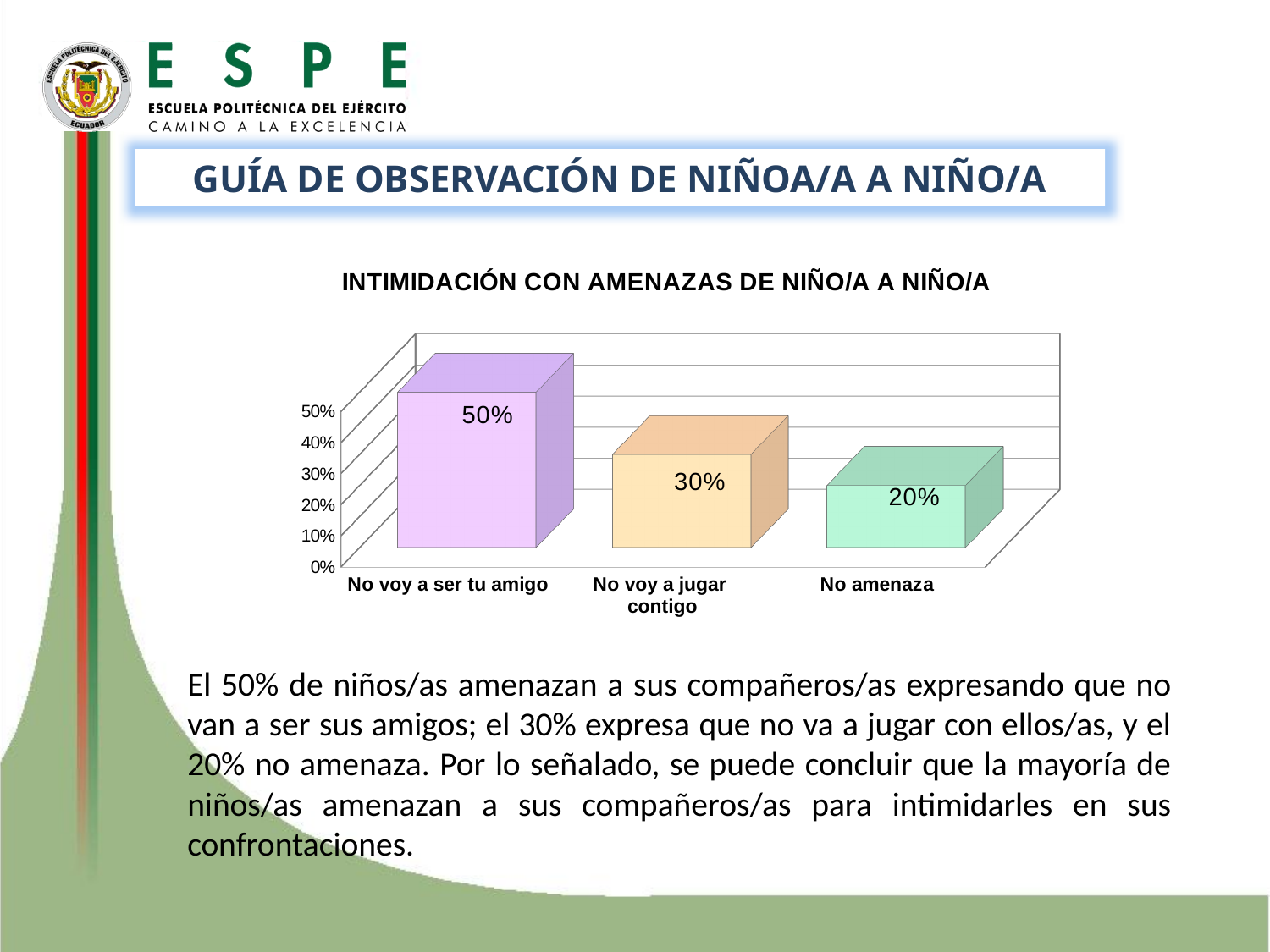
Which category has the lowest value? No amenaza What is the value for "No amenaza"? 20% Which category has the highest value? No voy a ser tu amigo How many categories are shown on the chart? 3 What is the difference between the values for "No voy a ser tu amigo" and "No amenaza"? 30% What is the title of the chart? INTIMIDACIÓN CON AMENAZAS DE NIÑO/A A NIÑO/A What is the value for "No voy a ser tu amigo"? 50% What is the difference between the values for "No voy a jugar contigo" and "No amenaza"? 10% Do the values rise or fall from left to right along the x axis? Fall What kind of chart is shown on the slide? Bar chart What is the value for "No voy a jugar contigo"? 30% Which is larger, the value for "No voy a jugar contigo" or the value for "No amenaza"? No voy a jugar contigo